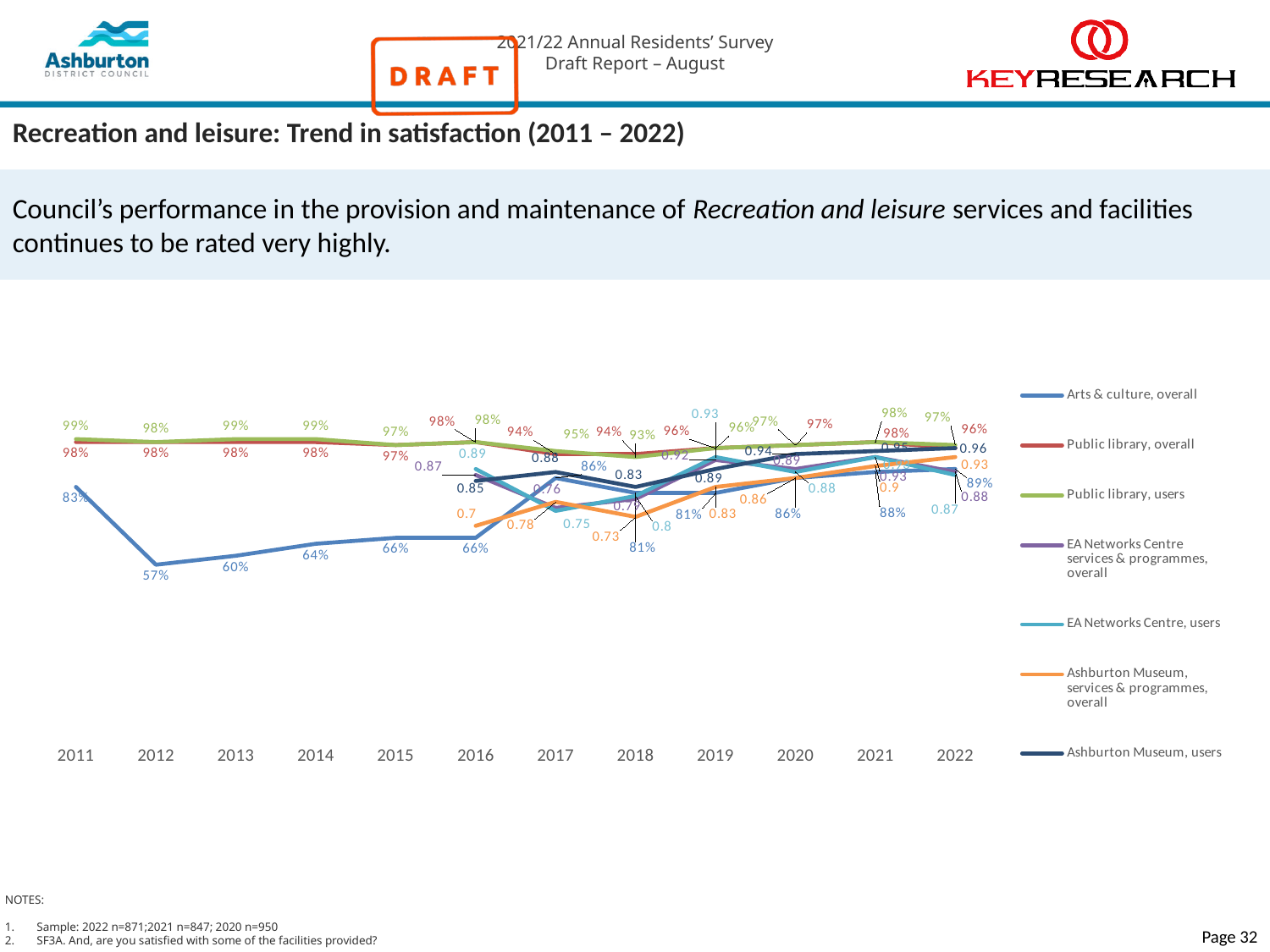
What kind of chart is shown on the slide? Line chart What is the value for Arts & culture, overall in 2011? 83% Which is larger for Arts & culture, overall: the 2013 value or the 2014 value? 2014 (64%) What is the value for Public library, users in 2011? 99% Does the Arts & culture, overall series rise or fall from 2012 to 2022? Rises What is the difference between the Arts & culture, overall values for 2011 and 2012? 26 percentage points In which year is the Arts & culture, overall series at its lowest? 2012 What is the title of the slide containing the chart? Recreation and leisure: Trend in satisfaction (2011 – 2022) How many series does the legend list? 7 What is the value for Arts & culture, overall in 2012? 57% What is the value for Ashburton Museum, services & programmes, overall in 2016? 0.7 How many years are shown along the x axis? 12